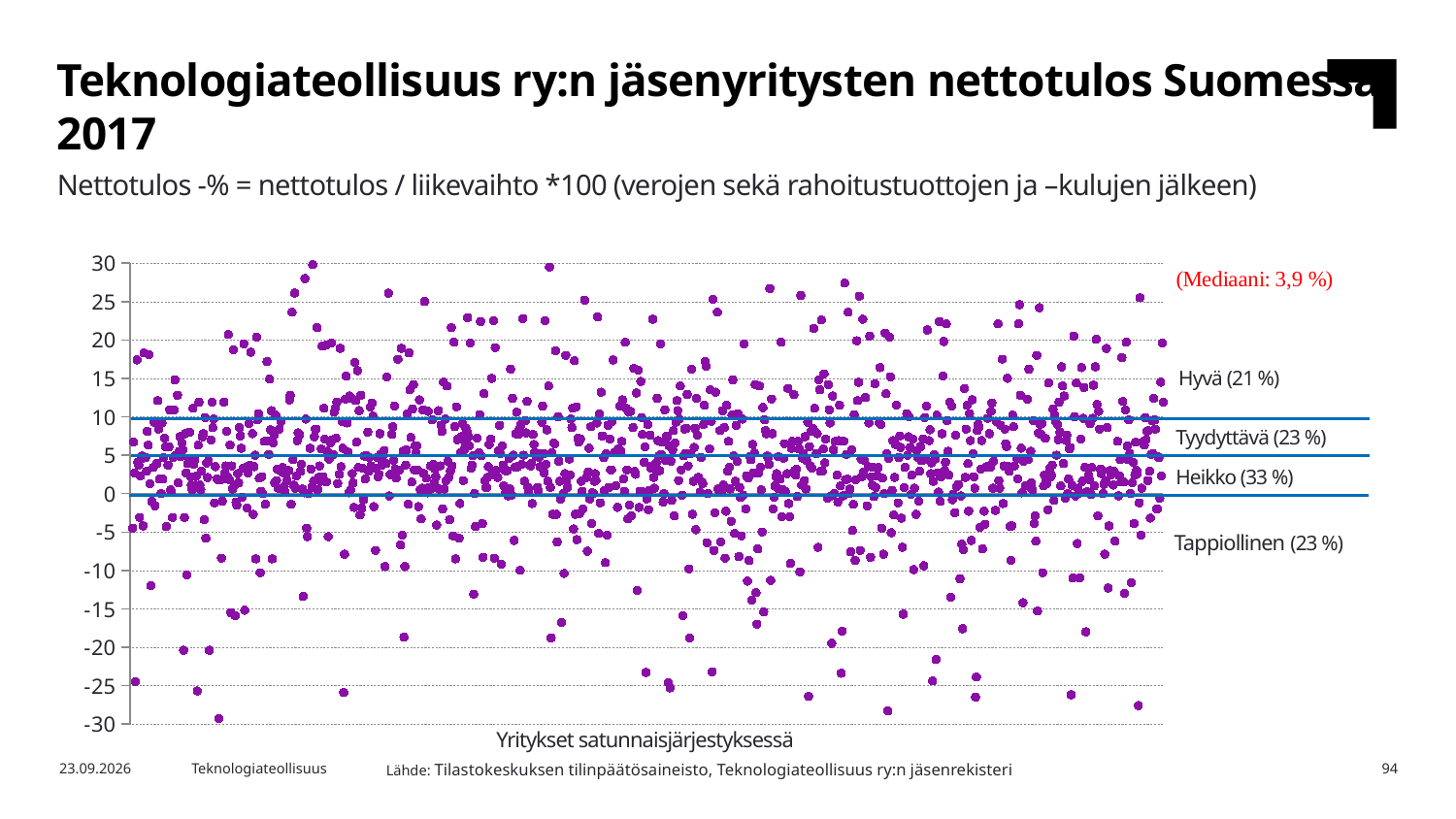
What share of companies falls into the 'Tappiollinen' category? 23 % What share of companies falls into the 'Hyvä' category? 21 % What is the difference in percentage points between the 'Heikko' share and the 'Hyvä' share? 12 What median value is stated on the chart? 3,9 % Which category has a larger share, 'Heikko' or 'Tappiollinen'? Heikko What kind of chart is shown on the slide? Scatter chart What share of companies falls into the 'Heikko' category? 33 % Which category has the largest share of companies? Heikko What is the label of the x axis? Yritykset satunnaisjärjestyksessä What share of companies falls into the 'Tyydyttävä' category? 23 % Which category has the smallest share of companies? Hyvä How many categories of companies are labelled on the chart? 4